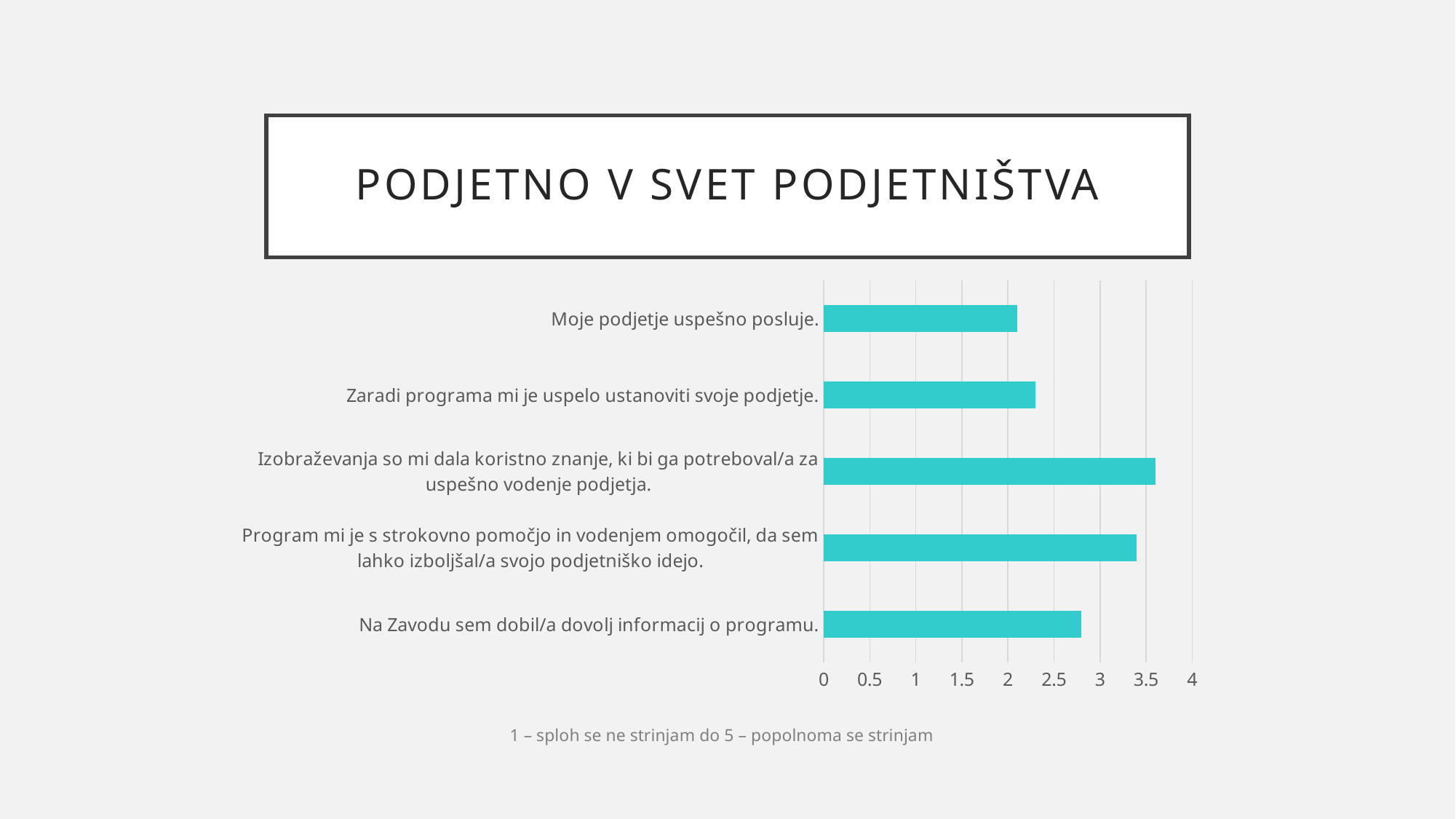
Is the value for "Moje podjetje uspešno posluje." greater or less than 2.5? less Is the value for "Zaradi programa mi je uspelo ustanoviti svoje podjetje." greater or less than 2.5? less Which has a larger value: "Na Zavodu sem dobil/a dovolj informacij o programu." or "Moje podjetje uspešno posluje."? Na Zavodu sem dobil/a dovolj informacij o programu. What is the title shown above the chart on the slide? PODJETNO V SVET PODJETNIŠTVA Is the value for "Na Zavodu sem dobil/a dovolj informacij o programu." greater or less than 3? less What kind of chart is shown on the slide? bar chart How many statements (categories) are plotted in the chart? 5 What is the maximum value shown on the horizontal axis of the chart? 4 Which has a larger value: "Zaradi programa mi je uspelo ustanoviti svoje podjetje." or "Program mi je s strokovno pomočjo in vodenjem omogočil, da sem lahko izboljšal/a svojo podjetniško idejo."? Program mi je s strokovno pomočjo in vodenjem omogočil, da sem lahko izboljšal/a svojo podjetniško idejo. Which statement has the highest value in the chart? Izobraževanja so mi dala koristno znanje, ki bi ga potreboval/a za uspešno vodenje podjetja.